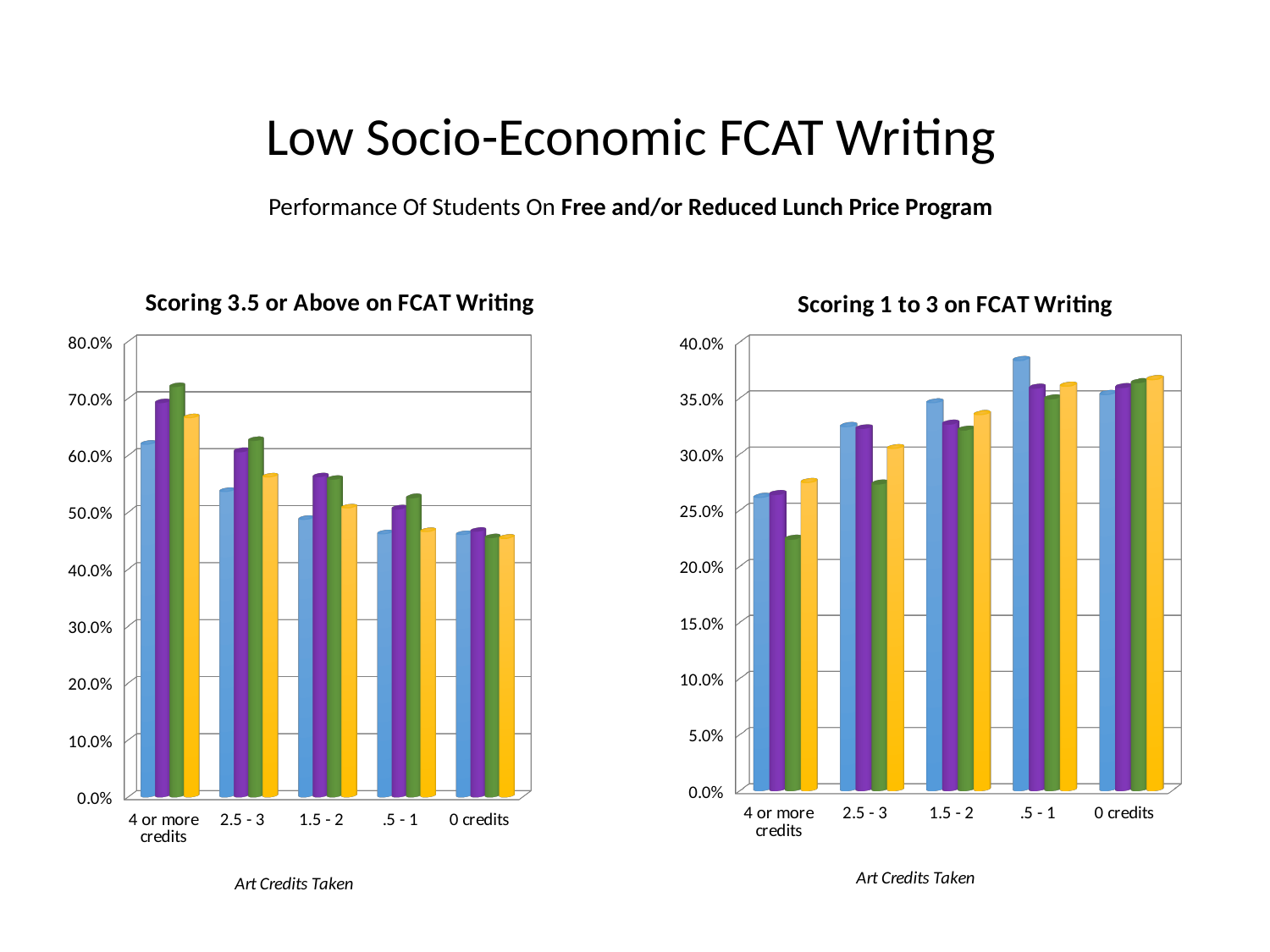
In the "Scoring 3.5 or Above on FCAT Writing" chart, is the purple bar for "4 or more credits" greater or less than 60.0%? greater In the "Scoring 3.5 or Above on FCAT Writing" chart, which is larger: the blue bar for "4 or more credits" or the blue bar for "0 credits"? 4 or more credits In the "Scoring 1 to 3 on FCAT Writing" chart, which category contains the tallest bar? .5 - 1 In the "Scoring 1 to 3 on FCAT Writing" chart, is the green bar for "4 or more credits" greater or less than 25.0%? less In the "Scoring 1 to 3 on FCAT Writing" chart, do the values generally rise or fall moving from "4 or more credits" to "0 credits"? Rise What is the x-axis label shown beneath both charts? Art Credits Taken What kind of chart is the "Scoring 3.5 or Above on FCAT Writing" chart? Bar chart In the "Scoring 3.5 or Above on FCAT Writing" chart, is the blue bar for "0 credits" greater or less than 50.0%? less In the "Scoring 3.5 or Above on FCAT Writing" chart, which category has the tallest bar? 4 or more credits In the "Scoring 3.5 or Above on FCAT Writing" chart, do the values generally rise or fall moving from "4 or more credits" to "0 credits"? Fall How many categories are shown on the x axis of the "Scoring 1 to 3 on FCAT Writing" chart? 5 In the "Scoring 1 to 3 on FCAT Writing" chart, which category has the lowest bars overall? 4 or more credits